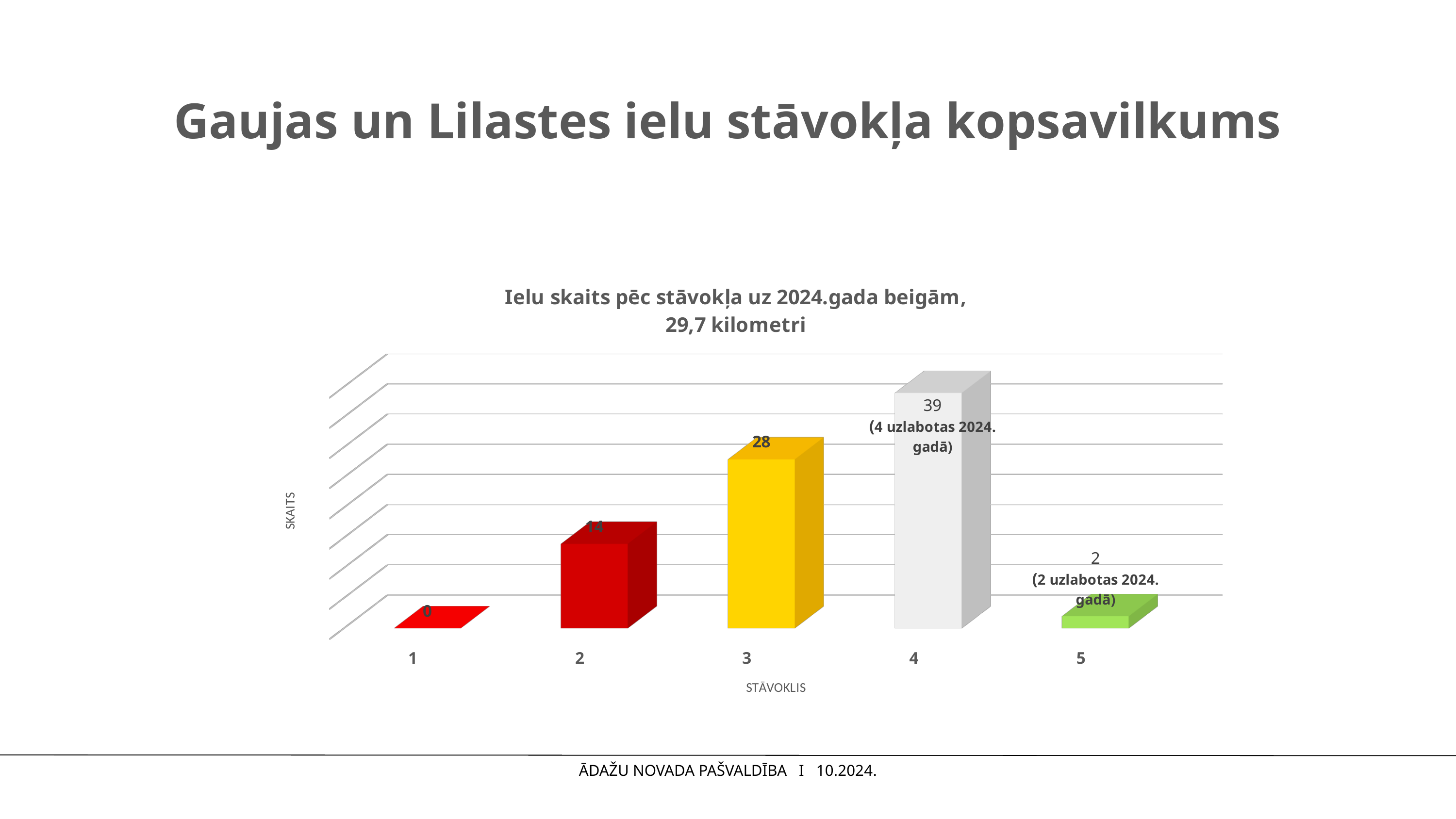
What is the difference between the values for category 4 and category 3? 11 Which category has the highest value? 4 What is the value for category 2? 14 Which is larger, the value for category 2 or the value for category 5? category 2 What is the value for category 3? 28 How many categories are shown on the x axis? 5 What kind of chart is shown on the slide? bar chart Which category has the lowest value? 1 What is the value for category 5? 2 What is the value for category 4? 39 What is the difference between the values for category 3 and category 2? 14 What is the label of the x axis? STĀVOKLIS